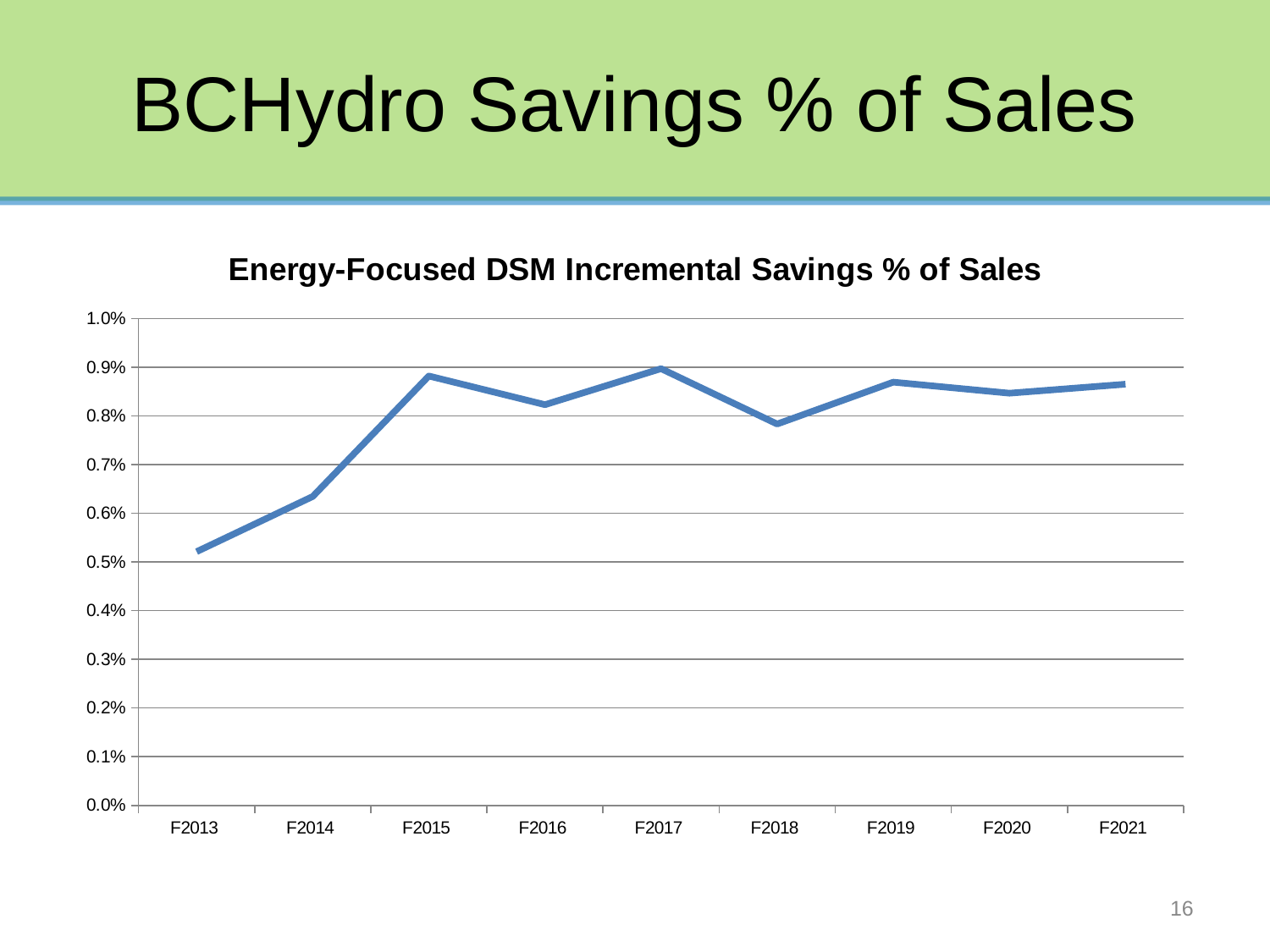
What is the title of the chart? Energy-Focused DSM Incremental Savings % of Sales Which is larger, the value for F2018 or the value for F2019? F2019 How many fiscal years are plotted along the x axis? 9 Which is larger, the value for F2013 or the value for F2015? F2015 Which fiscal year has the lowest savings % of sales? F2013 Is the value for F2014 greater or less than 0.7%? less Is the value for F2013 greater or less than 0.6%? less Is the value for F2015 greater or less than 0.8%? greater What kind of chart is shown on the slide? Line chart Do the values rise or fall from F2013 to F2015? rise